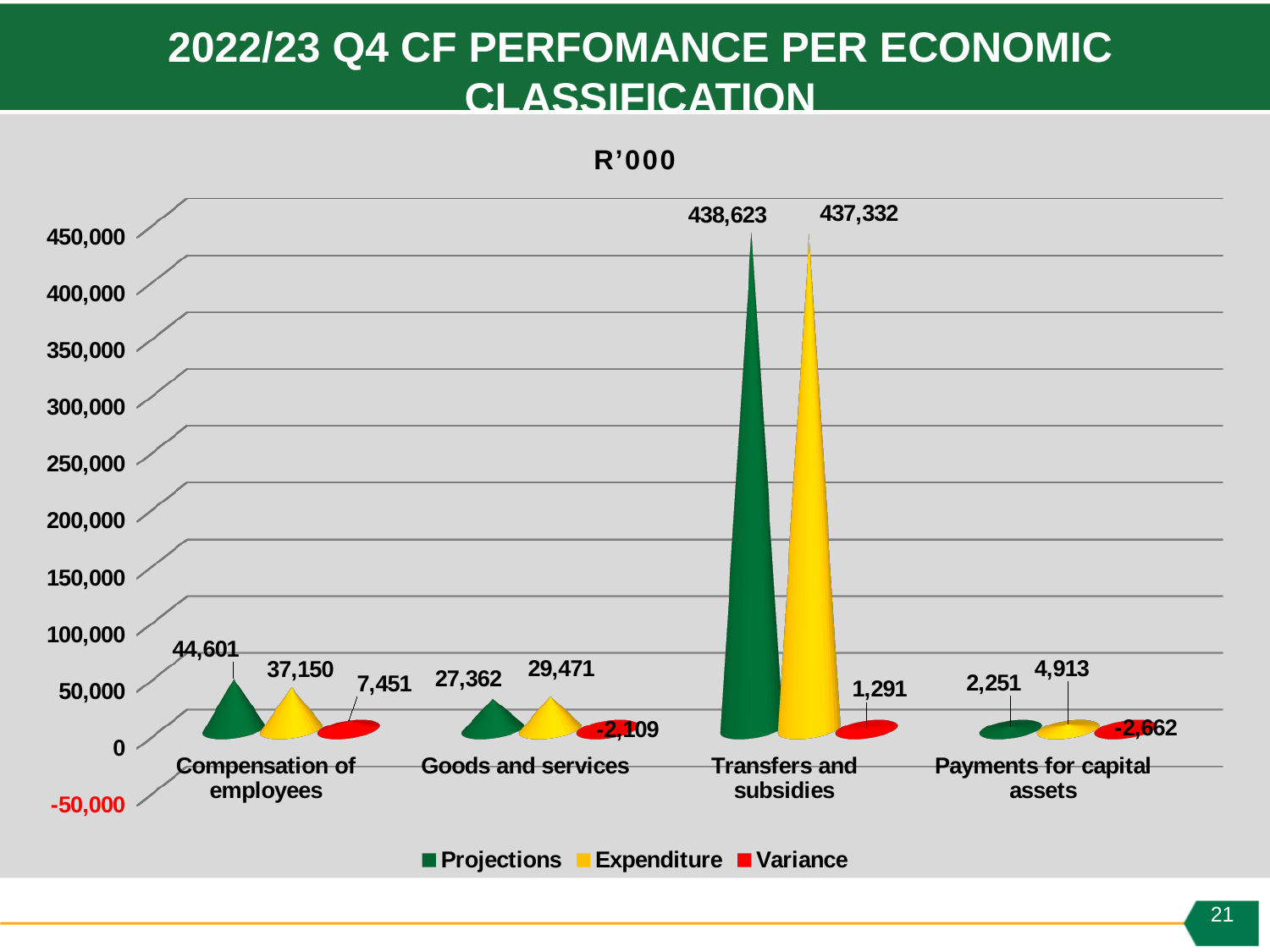
Which category has the highest Projections value? Transfers and subsidies What kind of chart is shown on the slide? Bar chart What is the Variance value for Goods and services? -2,109 How many series does the legend list? 3 What unit is shown above the chart? R'000 How many categories are shown on the x axis? 4 What is the difference between Projections and Expenditure for Compensation of employees? 7,451 Which category has the lowest Expenditure value? Payments for capital assets What is the Projections value for Transfers and subsidies? 438,623 What is the Expenditure value for Payments for capital assets? 4,913 What is the Expenditure value for Compensation of employees? 37,150 Which is larger for Goods and services, Projections or Expenditure? Expenditure